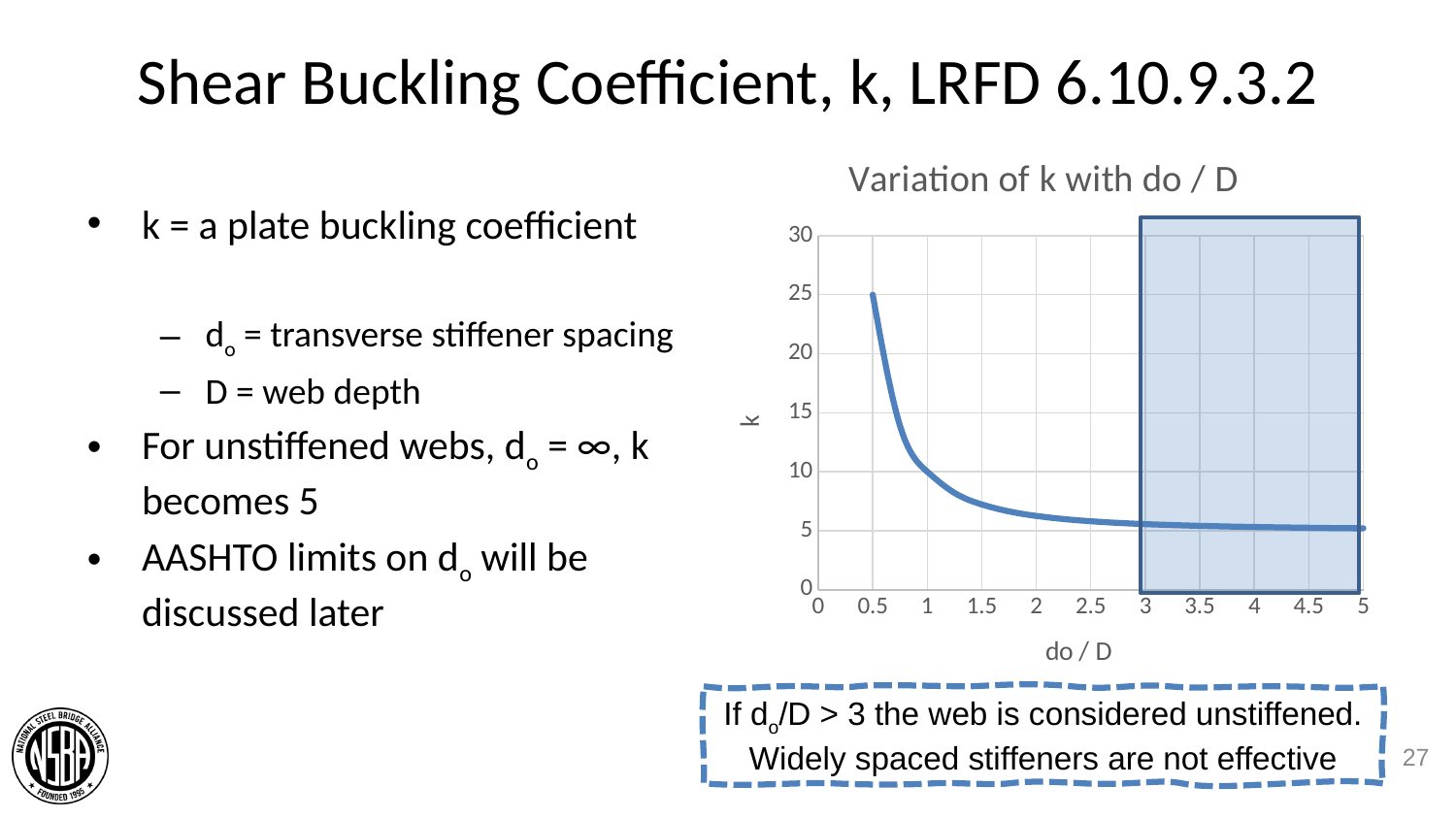
What kind of chart is shown on the slide? line chart Is the value of k at do / D = 1.5 greater or less than 5? greater Is the value of k at do / D = 4 greater or less than 10? less Does the value of k rise or fall as do / D increases along the x axis? fall At which value of do / D does the curve reach its highest k? 0.5 What is the highest value shown on the y axis of the chart? 30 Which is larger, k at do / D = 0.5 or k at do / D = 3? k at do / D = 0.5 What is the value of k at do / D = 0.5? 25 Is the value of k at do / D = 0.5 greater or less than 20? greater What is the label on the x axis of the chart? do / D What is the title of the chart? Variation of k with do / D